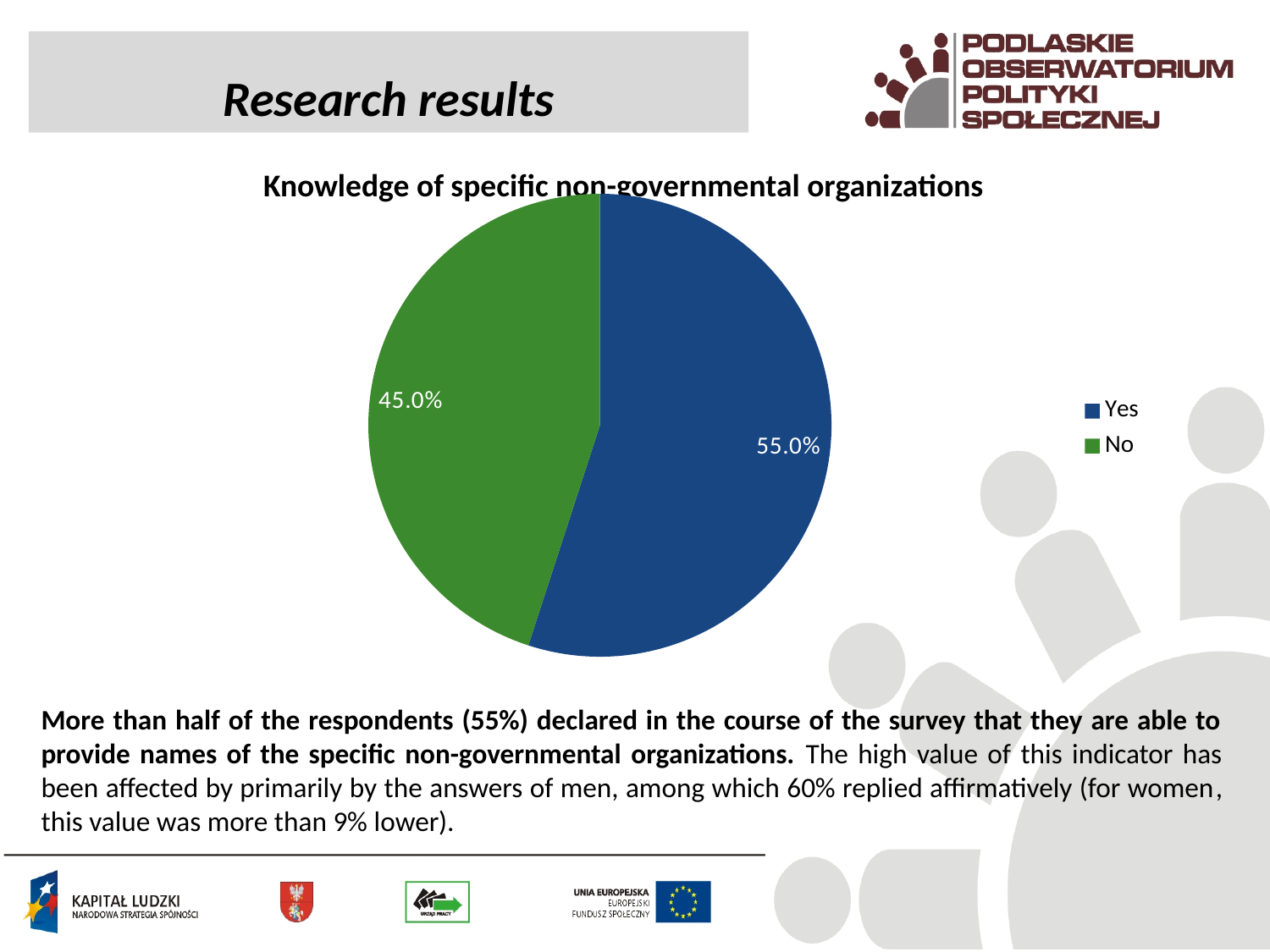
What share of the pie is labelled "Yes"? 55.0% What share of the pie is labelled "No"? 45.0% What colour is the "No" slice? green Which slice is the largest? Yes What is the title of the chart? Knowledge of specific non-governmental organizations What is the difference in percentage points between the "Yes" and "No" slices? 10.0% Is the share for "Yes" greater or less than 50%? greater How many slices does the pie chart have? 2 Which is larger, the "Yes" slice or the "No" slice? Yes What type of chart is shown on the slide? pie chart How many entries does the legend list? 2 Which slice is the smallest? No